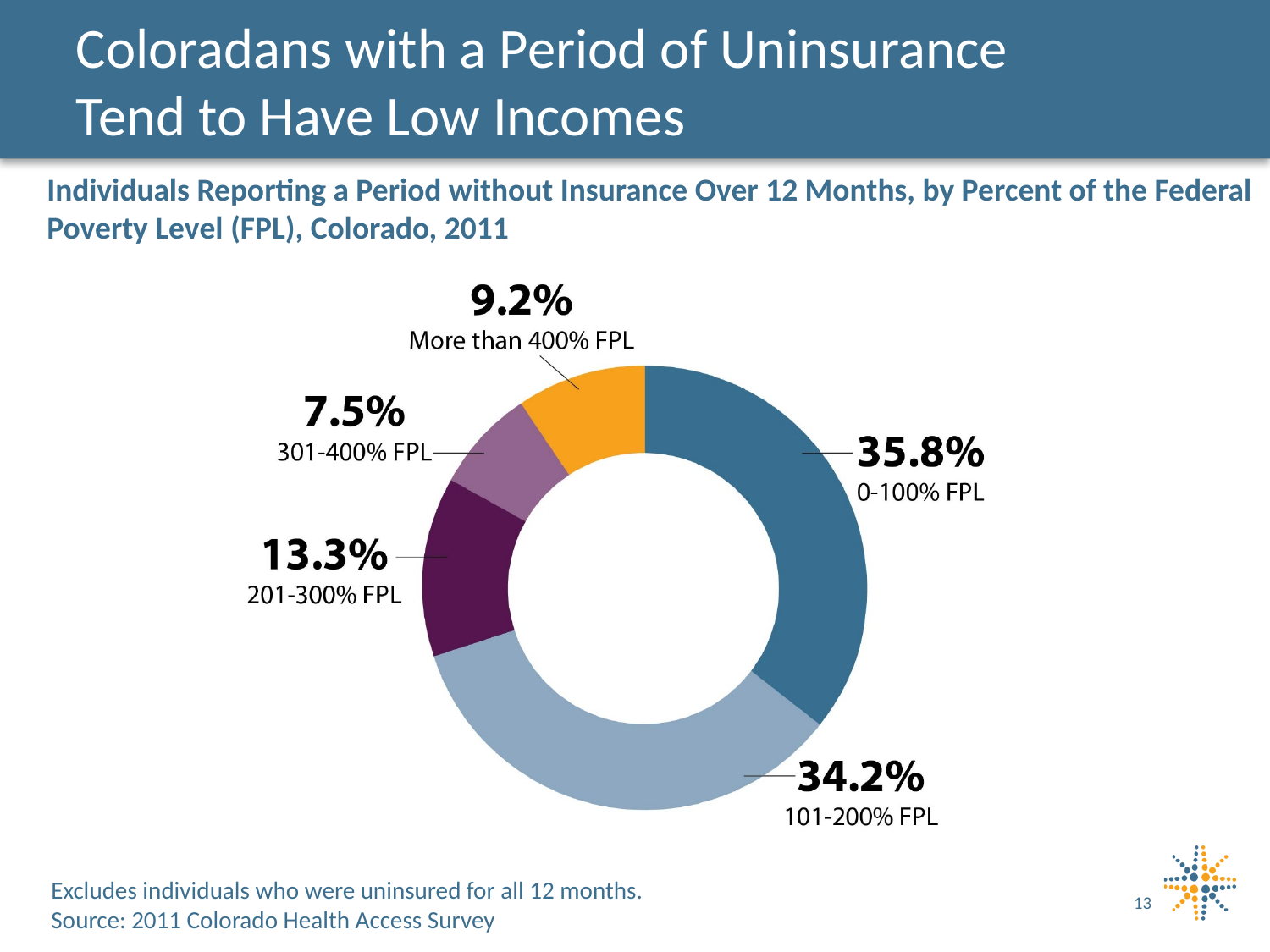
How many FPL categories are shown in the chart? 5 What is the value shown for 301-400% FPL? 7.5% What kind of chart is shown on the slide? Pie chart (donut) What is the value shown for 201-300% FPL? 13.3% Which FPL category has the smallest share? 301-400% FPL What is the difference between the 0-100% FPL share and the 101-200% FPL share? 1.6% What is the value shown for More than 400% FPL? 9.2% What percentage of individuals reporting a period without insurance are at 0-100% FPL? 35.8% What share of the chart is the 101-200% FPL slice? 34.2% What is the combined share of the 0-100% FPL and 101-200% FPL categories? 70.0% Which FPL category has the largest share? 0-100% FPL Which is larger, the share for More than 400% FPL or the share for 301-400% FPL? More than 400% FPL